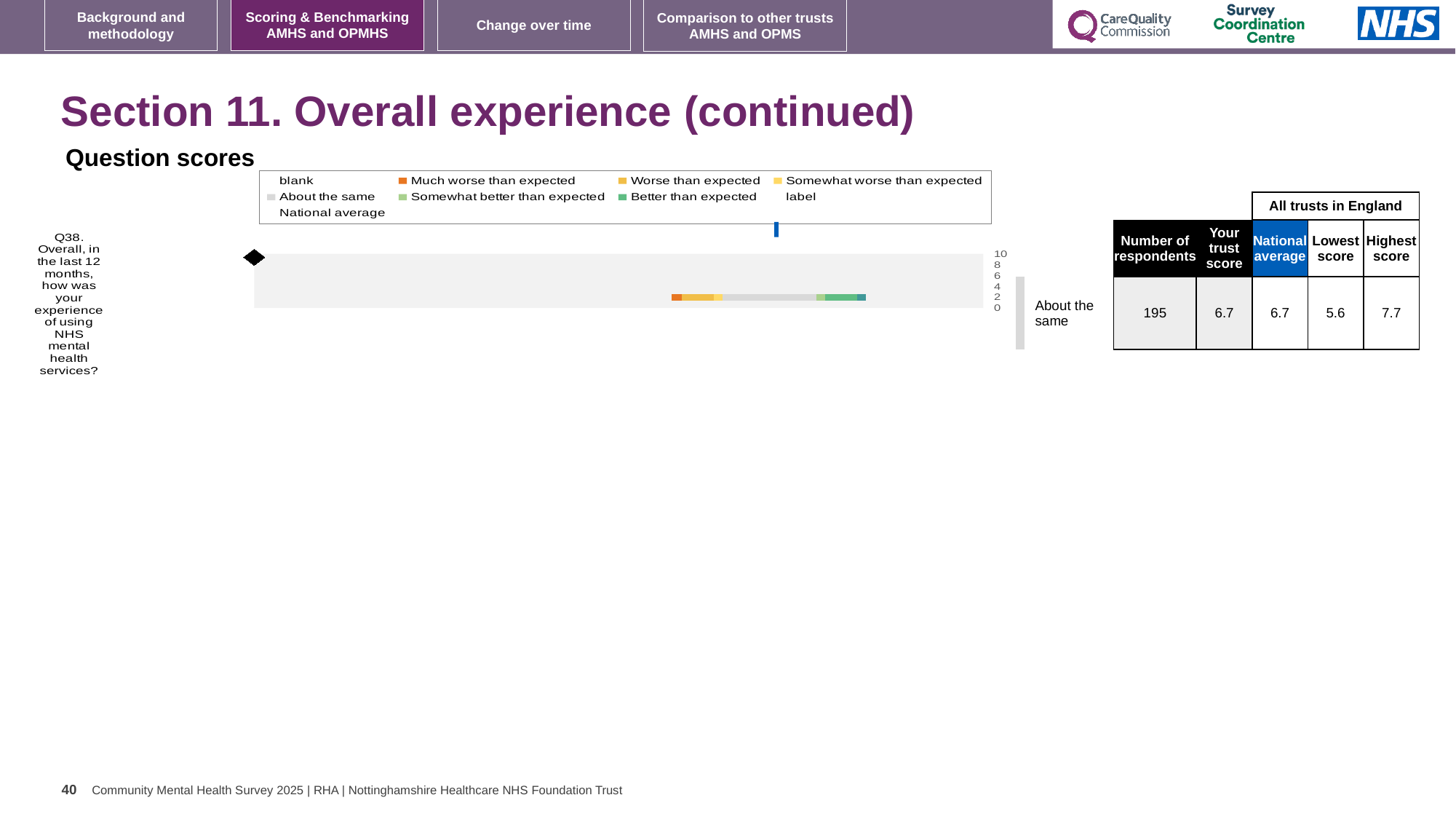
By how much does the highest score exceed the trust score for Q38? 1.0 Is the trust score for Q38 higher or lower than the national average? equal How many respondents are shown for Q38 in the table beside the chart? 195 What is the highest score among all trusts in England for Q38? 7.7 What is the difference between the highest and lowest trust scores for Q38? 2.1 What is the lowest score among all trusts in England for Q38? 5.6 What benchmark category label is shown next to the bar for Q38? About the same What colour represents 'Much worse than expected' in the chart legend? orange What kind of chart is used to show the Q38 question score? bar chart What is the trust score shown for Q38? 6.7 How many survey questions are plotted in the Question scores chart? 1 What is the national average score shown for Q38? 6.7